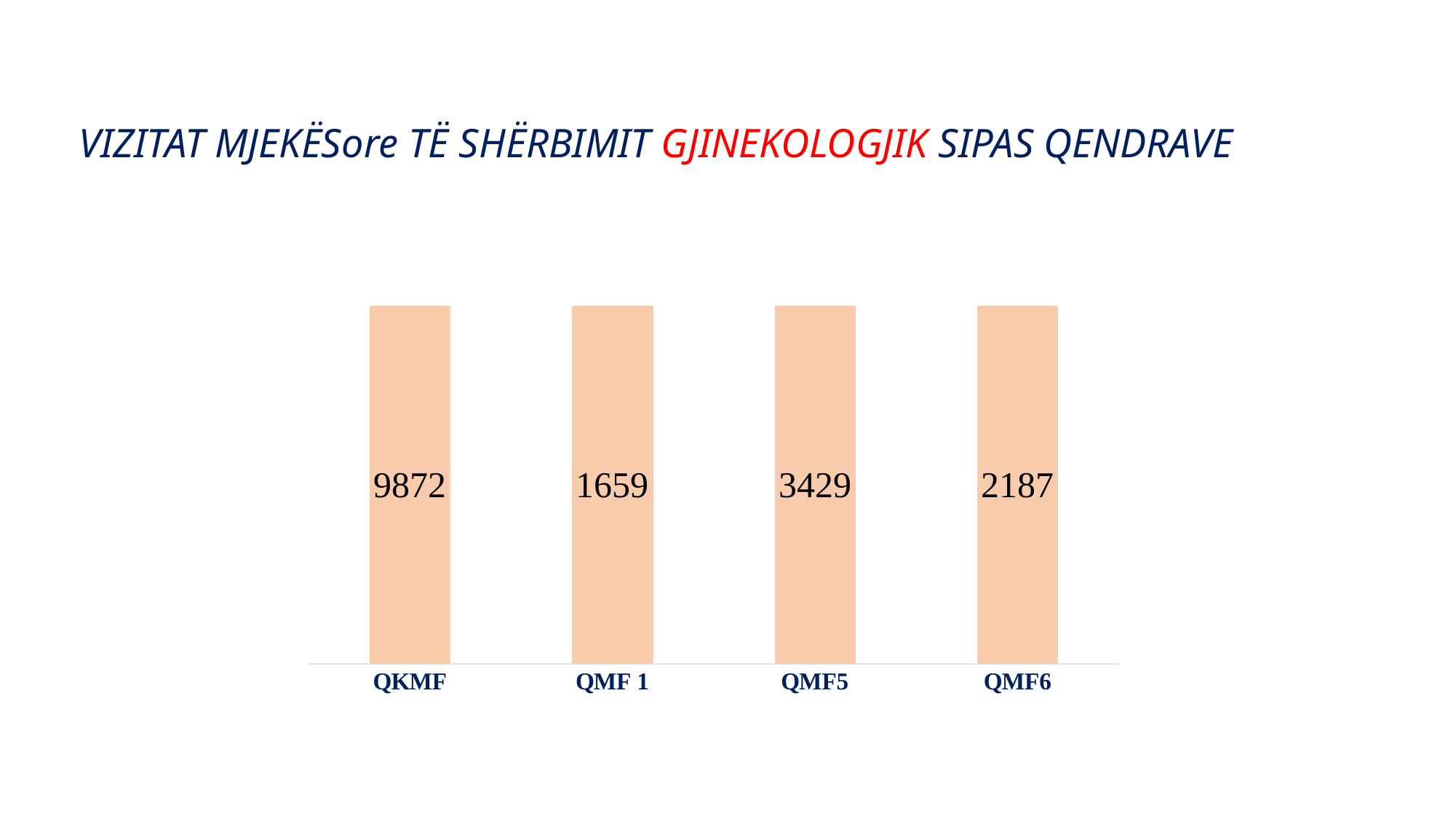
What is the total of the values for all four centres? 17147 Which centre has the lowest value? QMF 1 What is the value for QMF 1? 1659 What is the difference between the values for QMF6 and QMF 1? 528 What is the value for QMF5? 3429 How many centres are shown in the chart? 4 What is the value for QMF6? 2187 Which is larger, the value for QMF5 or the value for QMF6? QMF5 What is the difference between the values for QKMF and QMF5? 6443 What kind of chart is shown on the slide? bar chart Which centre has the highest value? QKMF What is the value for QKMF? 9872